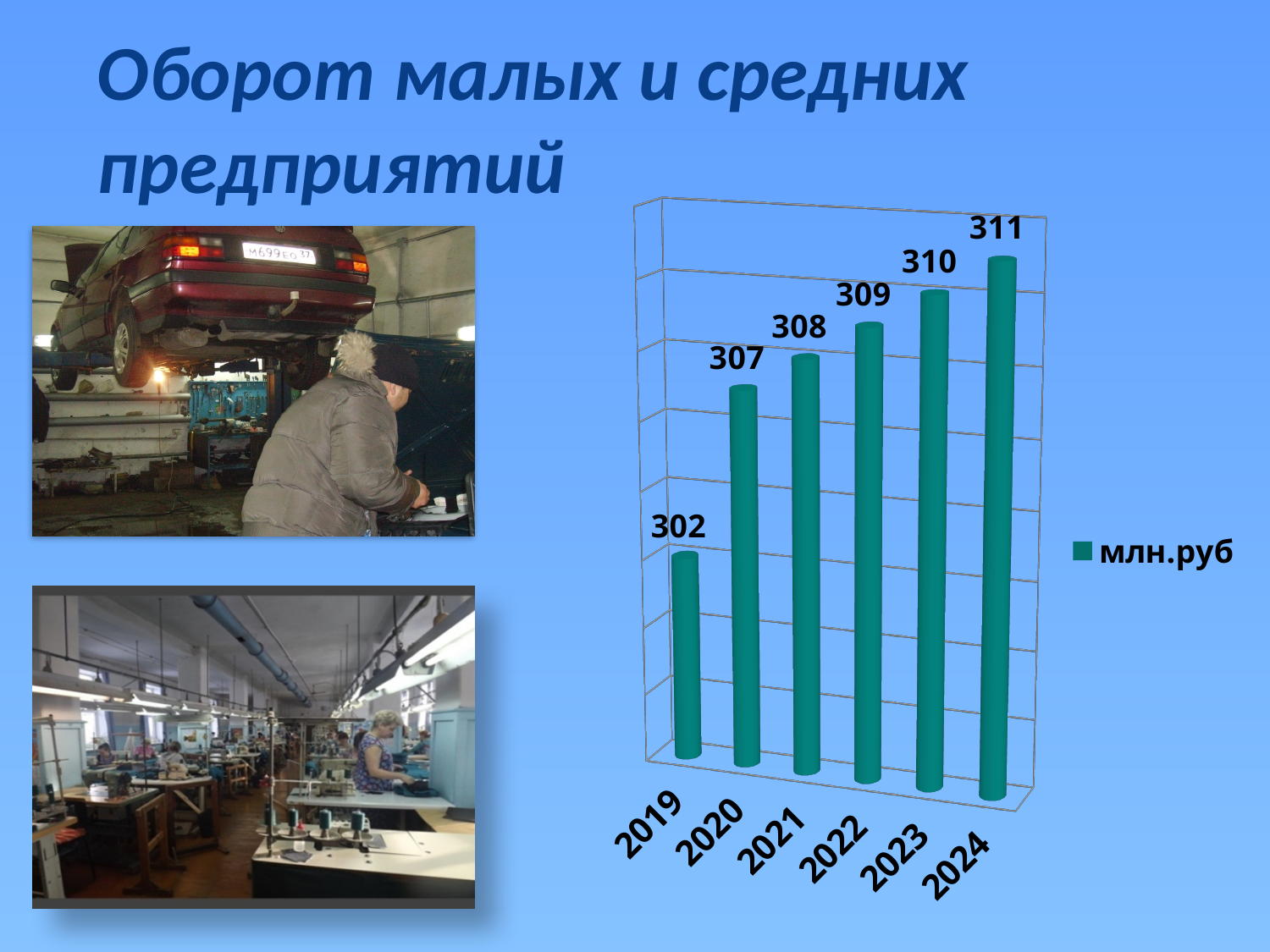
Which year has the highest value? 2024 Which is larger, the value for 2021 or the value for 2023? 2023 What is the value for 2024? 311 Do the values rise or fall from 2019 to 2024? rise How many years are shown on the chart? 6 What is the difference between the values for 2024 and 2019? 9 What is the difference between the values for 2020 and 2019? 5 What kind of chart is shown on the slide? bar chart What is the value for 2019? 302 How many series does the legend list? 1 Which year has the lowest value? 2019 What is the value for 2022? 309